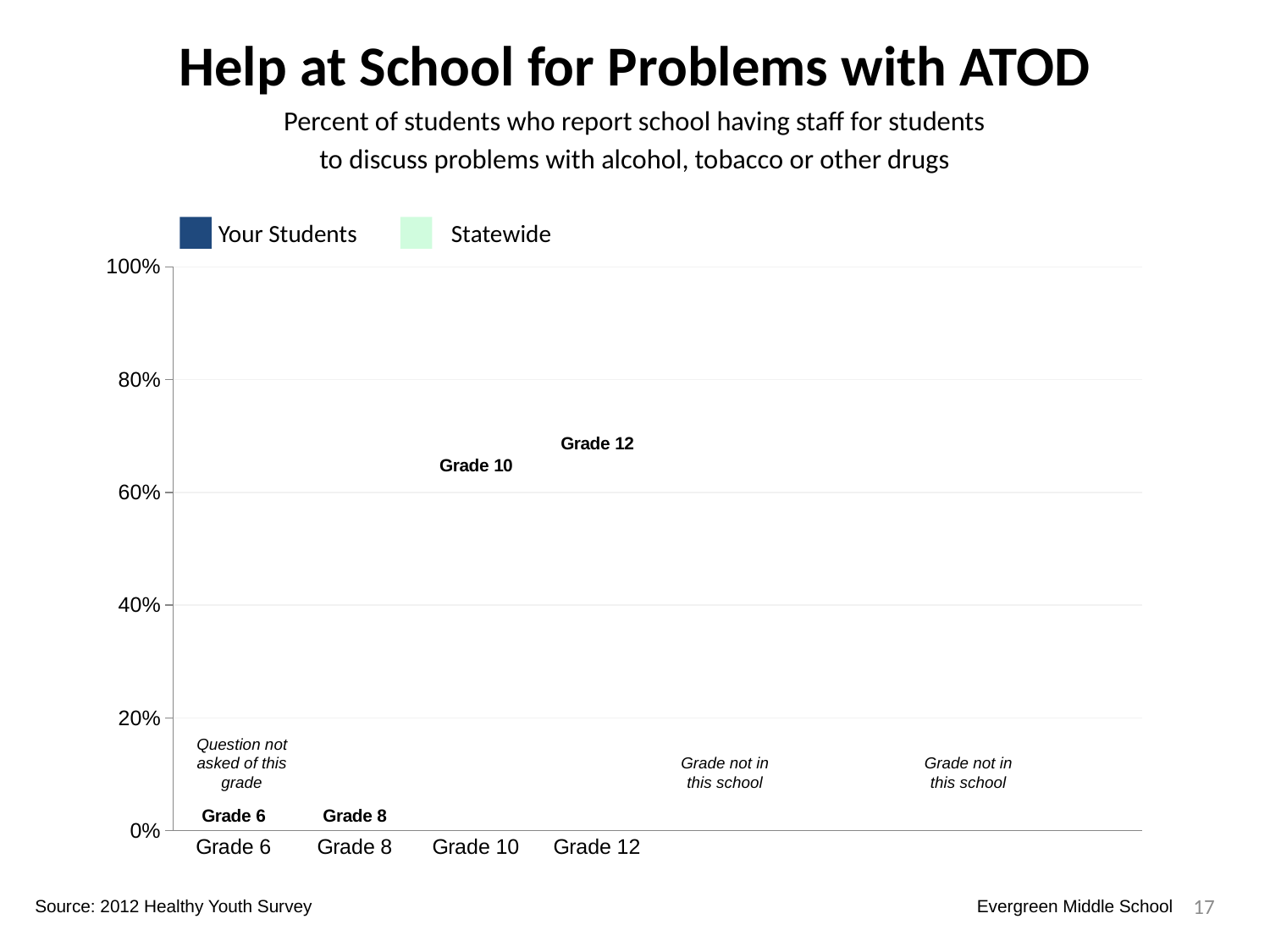
What note is shown for Grade 6 on the chart? Question not asked of this grade What are the two series named in the legend? Your Students and Statewide How many grade categories are shown on the x axis? 4 What survey is cited as the source of the chart? 2012 Healthy Youth Survey What is the highest value shown on the y axis? 100% What note appears twice on the right side of the chart? Grade not in this school What is the title of the chart? Help at School for Problems with ATOD Which grades are listed along the x axis? Grade 6, Grade 8, Grade 10, Grade 12 What is the lowest value shown on the y axis? 0% How many series does the legend list? 2